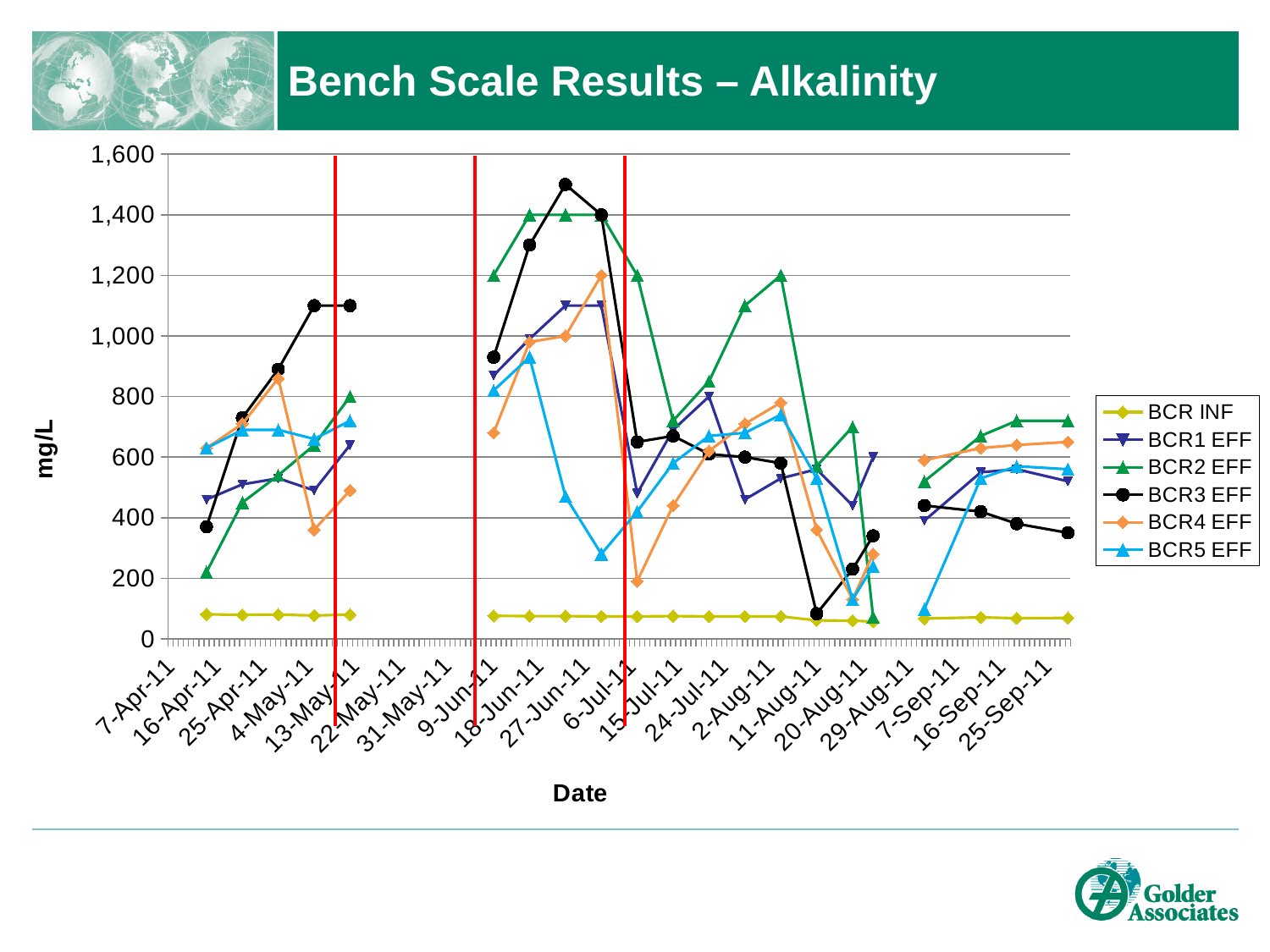
Is the value for BCR2 EFF on 16-Apr-11 greater or less than 400? less How many series does the legend list? 6 What is the label on the horizontal axis? Date Which series has the highest value on 27-Jun-11? BCR3 EFF Does BCR3 EFF rise or fall from 7-Sep-11 to 25-Sep-11? fall What is the label on the vertical axis? mg/L Is the value for BCR INF on 7-Apr-11 greater or less than 200? less Which series stays lowest across the whole chart? BCR INF What kind of chart is shown on the slide? line chart On 25-Sep-11, which is larger: BCR2 EFF or BCR3 EFF? BCR2 EFF